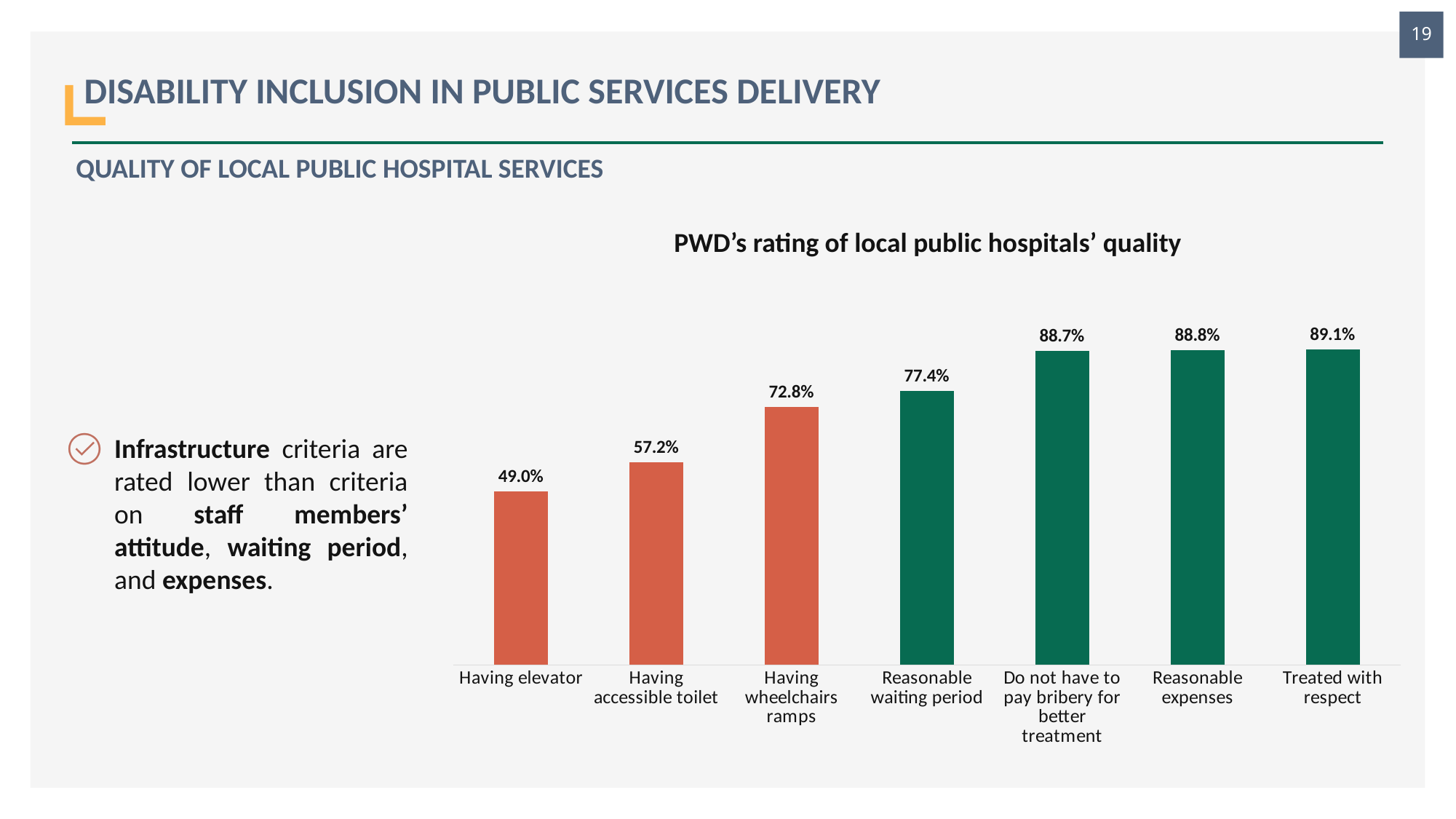
Which is larger, Reasonable waiting period or Having wheelchairs ramps? Reasonable waiting period What is the title of the chart? PWD's rating of local public hospitals' quality What is the difference between Treated with respect and Having elevator? 40.1% How many categories are shown in the chart? 7 What is the value for Having elevator? 49.0% What is the difference between Having wheelchairs ramps and Having accessible toilet? 15.6% Which category has the lowest value? Having elevator What is the value for Reasonable waiting period? 77.4% Which category has the highest value? Treated with respect What is the value for Do not have to pay bribery for better treatment? 88.7% Do the values rise or fall from left to right along the x axis? Rise What kind of chart is this? Bar chart